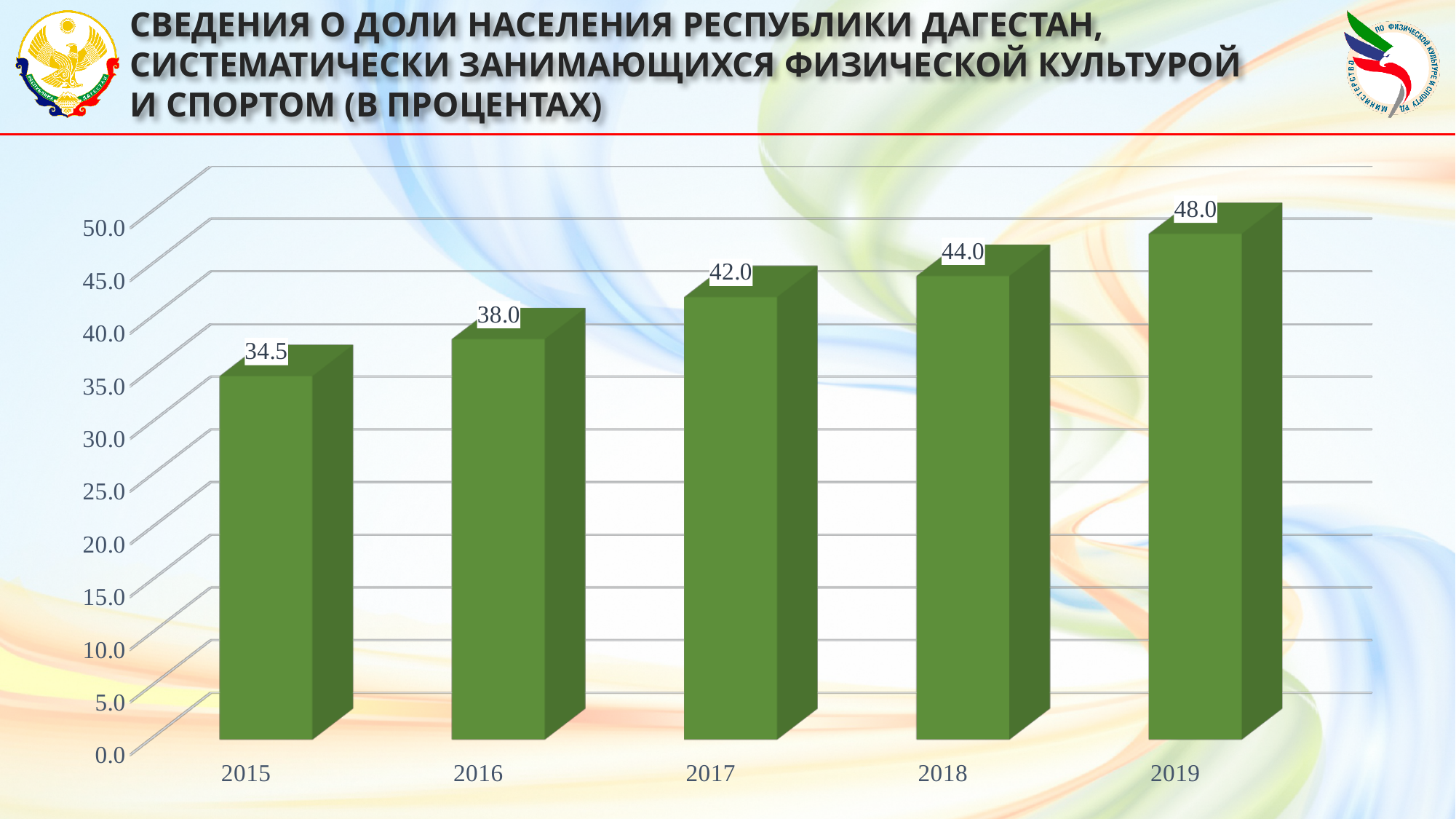
What is the difference between the values for 2019 and 2015? 13.5 Which is larger, the value for 2016 or the value for 2018? 2018 How many years are shown on the x axis? 5 Which year has the lowest value? 2015 Do the values rise or fall from 2015 to 2019? rise What kind of chart is shown on the slide? bar chart Which year has the highest value? 2019 What is the value for 2015? 34.5 What is the value for 2019? 48.0 What is the value for 2017? 42.0 What is the difference between the values for 2018 and 2016? 6.0 Is the value for 2017 greater or less than 40.0? greater